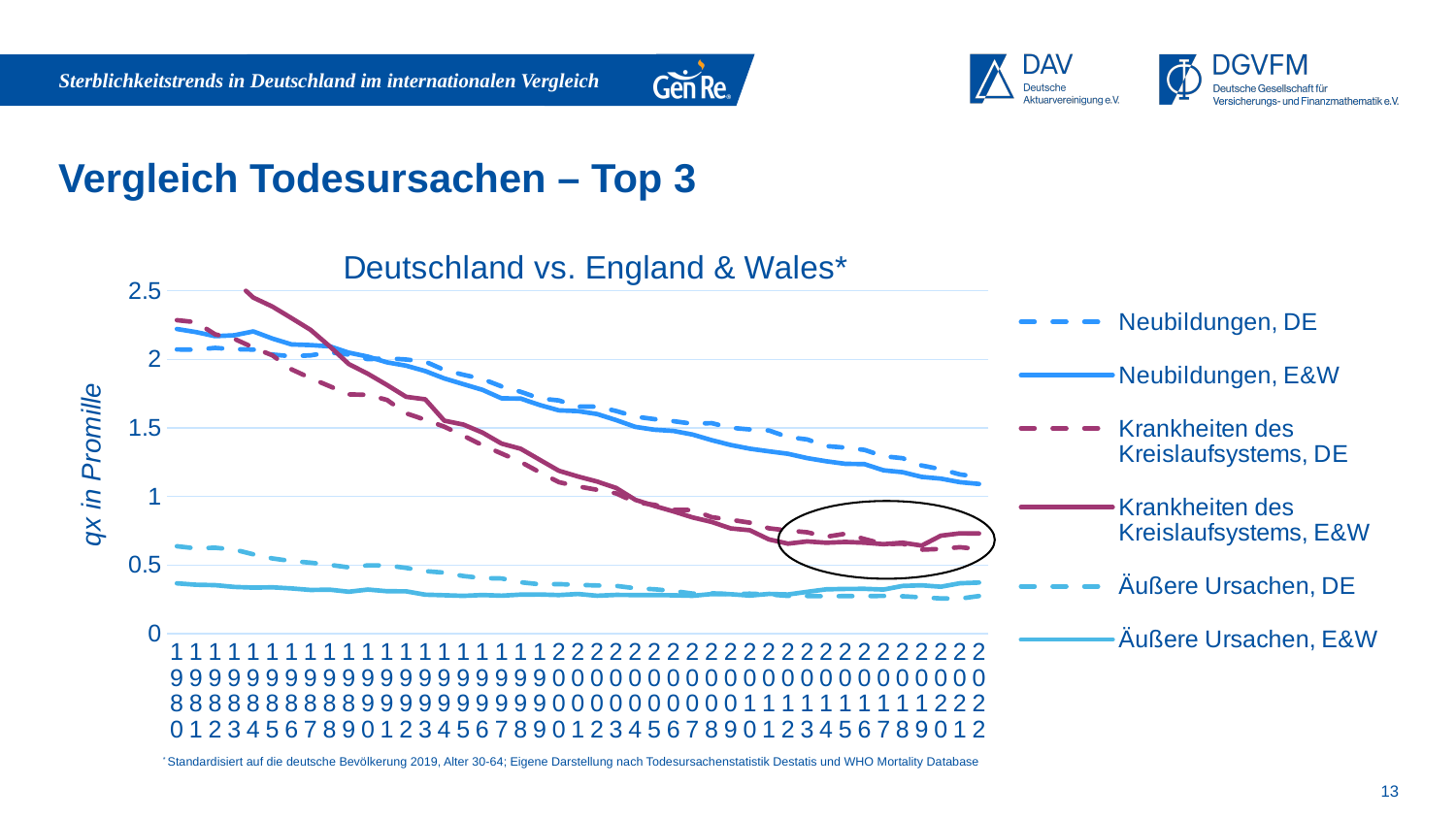
How many series does the legend of the chart list? 6 What is the label of the vertical axis of the chart? qx in Promille Is the value for Krankheiten des Kreislaufsystems, E&W in 1984 greater or less than 2? greater Does the line for Krankheiten des Kreislaufsystems, E&W rise or fall over the period shown? fall Which series has the lowest value in 2022? Äußere Ursachen, DE Is the value for Neubildungen, E&W in 2022 greater or less than 1.5? less In 2000, which is larger: Neubildungen, E&W or Äußere Ursachen, E&W? Neubildungen, E&W What kind of chart is shown on the slide? line chart What is the title of the chart? Deutschland vs. England & Wales* Is the value for Äußere Ursachen, DE in 1980 greater or less than 0.5? greater Does the line for Neubildungen, E&W rise or fall from 1980 to 2022? fall Which series has the highest value at the start of its line, in 1983? Krankheiten des Kreislaufsystems, E&W